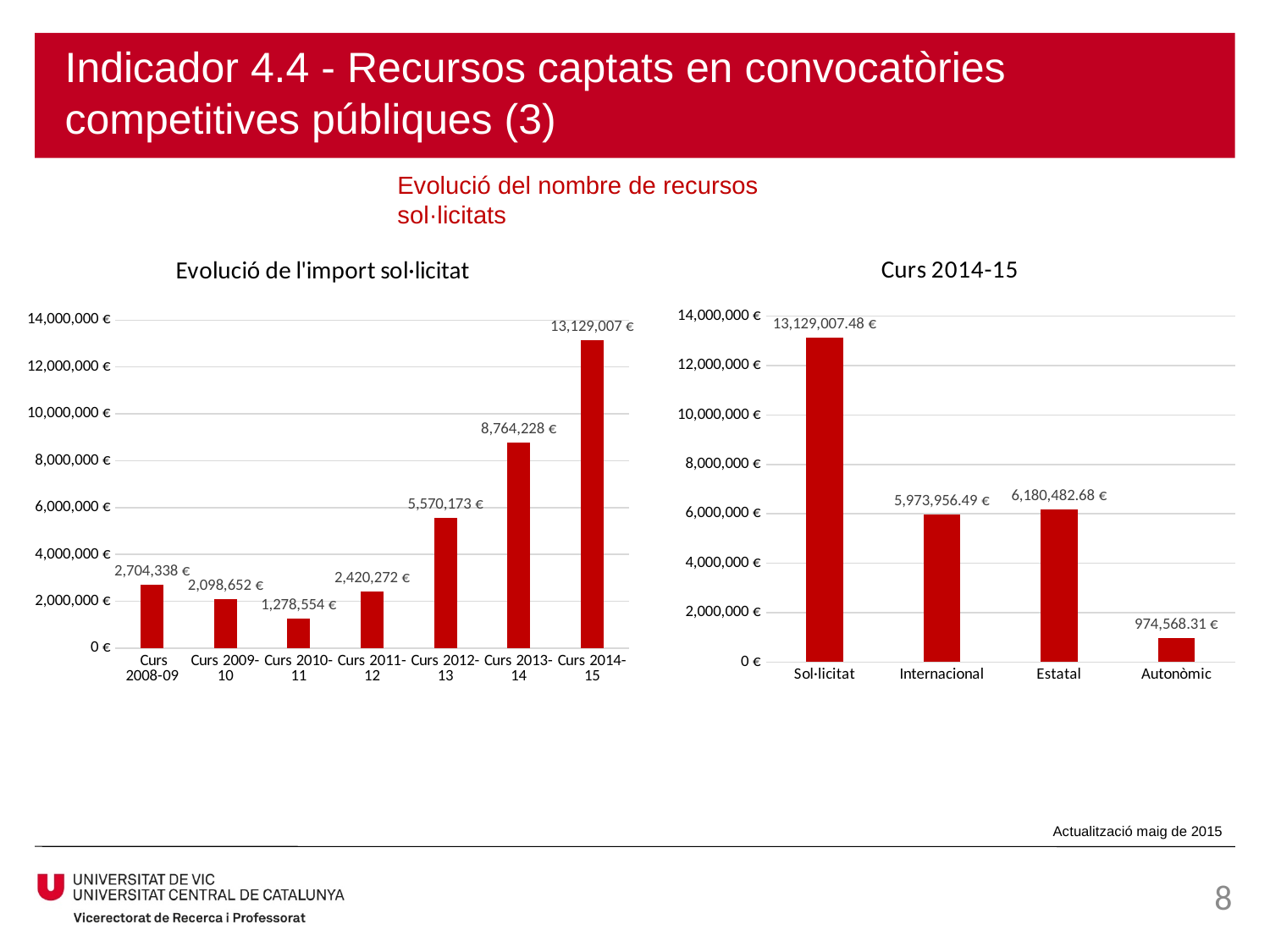
In the chart 'Curs 2014-15', which is larger, Estatal or Internacional? Estatal In the chart 'Evolució de l'import sol·licitat', what is the value for Curs 2012-13? 5,570,173 € In the chart 'Curs 2014-15', what is the value for Internacional? 5,973,956.49 € In the chart 'Evolució de l'import sol·licitat', is the value for Curs 2009-10 greater or less than 2,000,000 €? greater In the chart 'Curs 2014-15', which category has the lowest value? Autonòmic In the chart 'Evolució de l'import sol·licitat', which course has the lowest value? Curs 2010-11 In the chart 'Evolució de l'import sol·licitat', which course has the highest value? Curs 2014-15 In the chart 'Curs 2014-15', what is the value for Autonòmic? 974,568.31 € In the chart 'Evolució de l'import sol·licitat', what is the difference between the values for Curs 2014-15 and Curs 2013-14? 4,364,779 € In the chart 'Evolució de l'import sol·licitat', how many courses are shown on the x axis? 7 In the chart 'Evolució de l'import sol·licitat', do the values generally rise or fall from Curs 2010-11 to Curs 2014-15? rise What type of chart is the chart titled 'Curs 2014-15'? bar chart